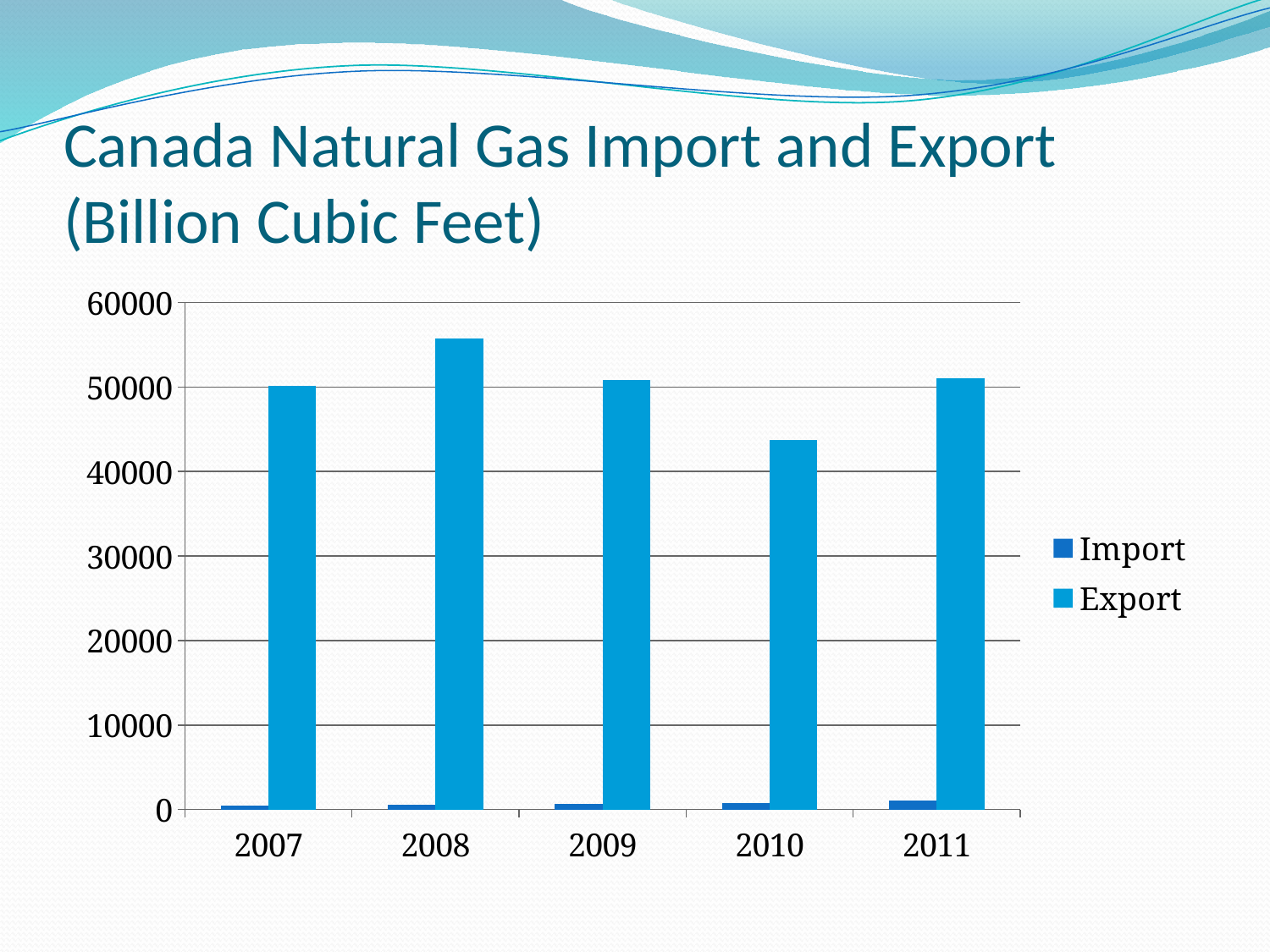
Does the Export value rise or fall from 2008 to 2010? fall Is the Export value for 2008 greater or less than 50000? greater What kind of chart is shown on the slide? bar chart Is the Export value for 2007 greater or less than 40000? greater Which is larger, the Export value for 2008 or the Export value for 2010? 2008 Is the Export value for 2010 greater or less than 50000? less How many series does the legend list? 2 How many years are shown on the x axis? 5 What are the two series named in the legend? Import and Export In 2009, which series has the larger value, Import or Export? Export Which year has the lowest Export value? 2010 Which year has the highest Export value? 2008